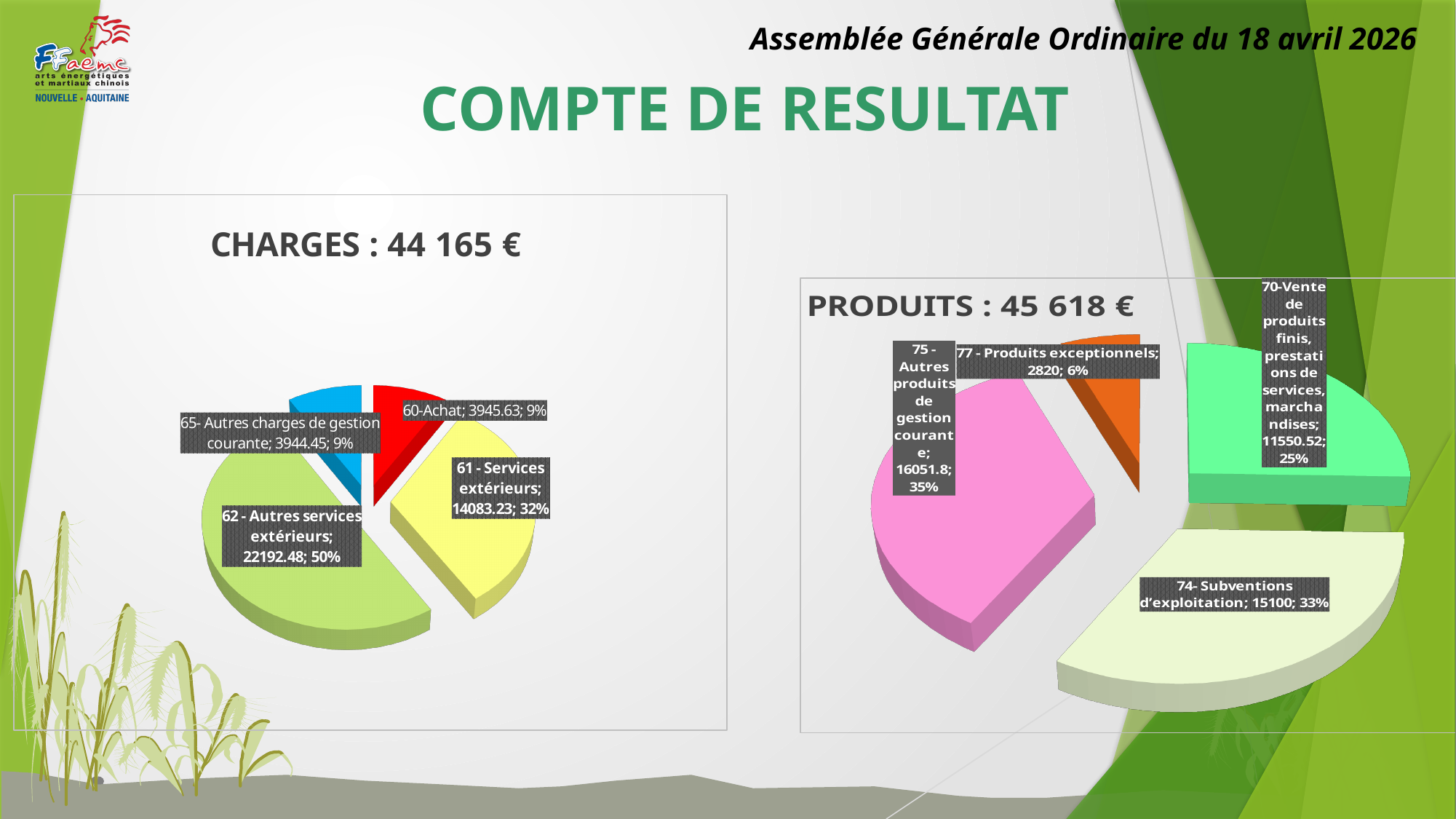
In the CHARGES pie chart, what share of the pie is 61 - Services extérieurs? 32% In the PRODUITS pie chart, what is the difference between 74- Subventions d'exploitation and 77 - Produits exceptionnels? 12280 In the PRODUITS pie chart, what share of the pie is 70-Vente de produits finis, prestations de services, marchandises? 25% In the CHARGES pie chart, what is the difference between 62 - Autres services extérieurs and 61 - Services extérieurs? 8109.25 In the PRODUITS pie chart, which category is the smallest? 77 - Produits exceptionnels In the CHARGES pie chart, which category is the largest? 62 - Autres services extérieurs In the PRODUITS pie chart, what is the value for 74- Subventions d'exploitation? 15100 In the PRODUITS pie chart, which is larger: 75 - Autres produits de gestion courante or 74- Subventions d'exploitation? 75 - Autres produits de gestion courante In the CHARGES pie chart, what is the value for 62 - Autres services extérieurs? 22192.48 What kind of chart is the CHARGES chart? Pie chart In the CHARGES pie chart, how many slices are there? 4 What is the total shown in the title of the PRODUITS chart? 45 618 €